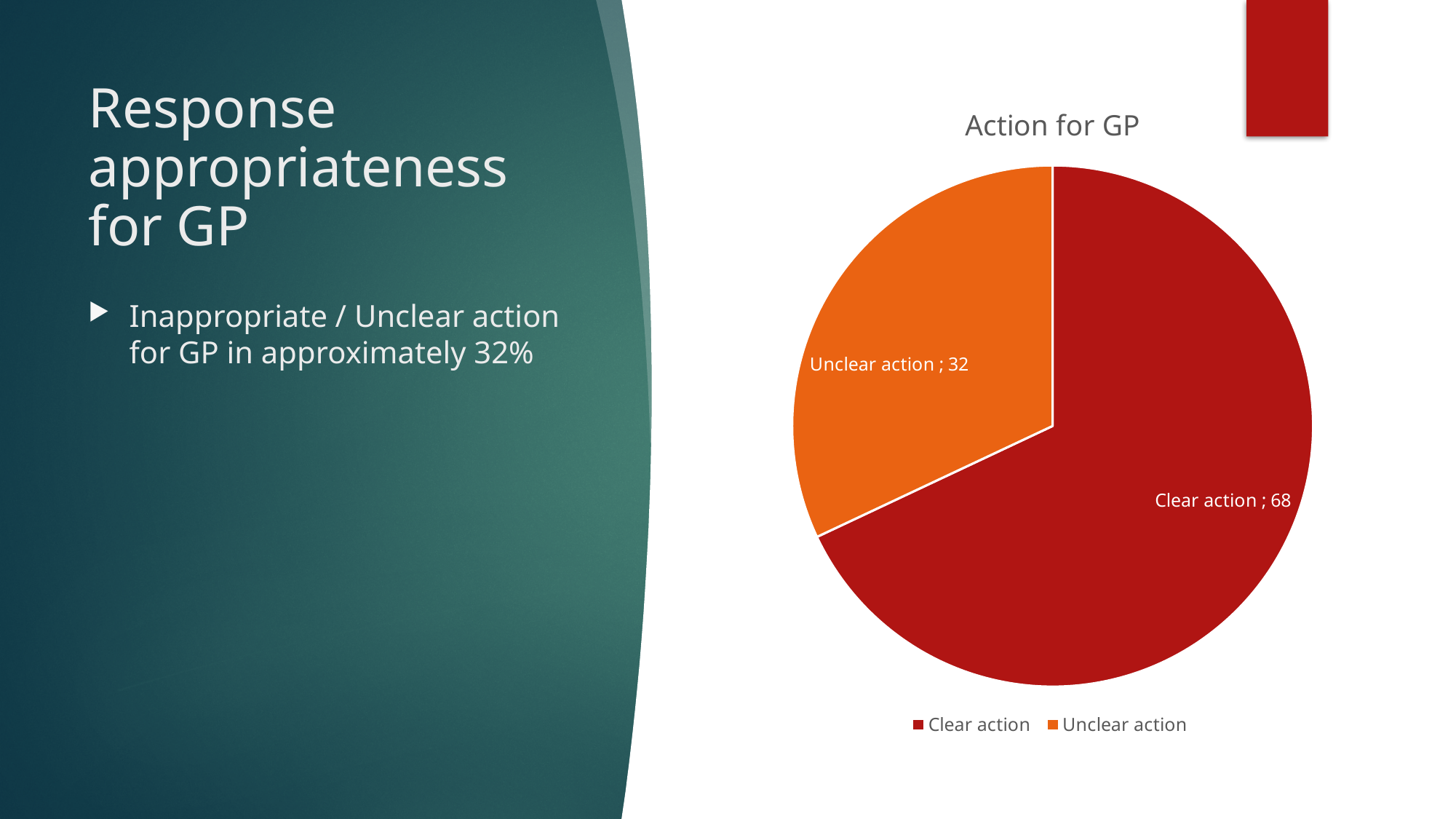
What is the value for Unclear action? 32 What is the title of the chart? Action for GP Which slice is the smallest? Unclear action What share of the pie does Unclear action represent? 32% How many slices does the pie chart have? 2 What colour is the Clear action slice? red What is the difference between the Clear action and Unclear action values? 36 How many entries does the legend list? 2 Which slice is the largest? Clear action What is the value for Clear action? 68 What type of chart is shown on the slide? pie chart Which is larger, Clear action or Unclear action? Clear action